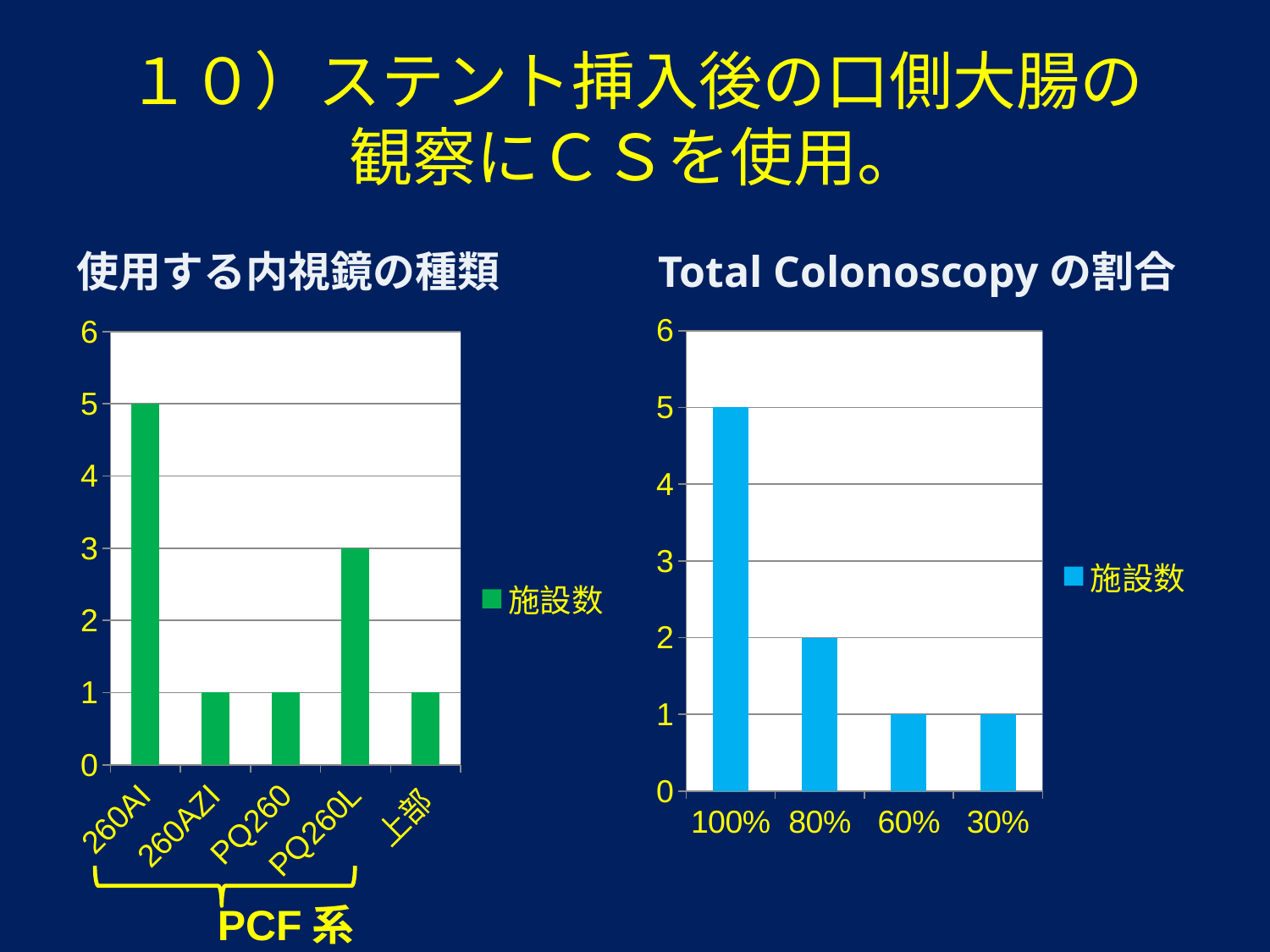
In the chart titled 使用する内視鏡の種類, what is the value for 260AI? 5 In the chart titled Total Colonoscopy の割合, what series name does the legend show? 施設数 In the chart titled Total Colonoscopy の割合, what is the value for 80%? 2 In the chart titled Total Colonoscopy の割合, how many categories are shown on the x axis? 4 In the chart titled Total Colonoscopy の割合, what kind of chart is it? bar chart In the chart titled 使用する内視鏡の種類, what is the difference between the values for 260AI and PQ260L? 2 In the chart titled 使用する内視鏡の種類, which is larger, the value for PQ260L or the value for 260AZI? PQ260L In the chart titled 使用する内視鏡の種類, which category has the highest value? 260AI In the chart titled 使用する内視鏡の種類, how many categories are shown on the x axis? 5 In the chart titled 使用する内視鏡の種類, what is the value for PQ260L? 3 In the chart titled Total Colonoscopy の割合, what is the value for 100%? 5 In the chart titled Total Colonoscopy の割合, which category has the highest value? 100%